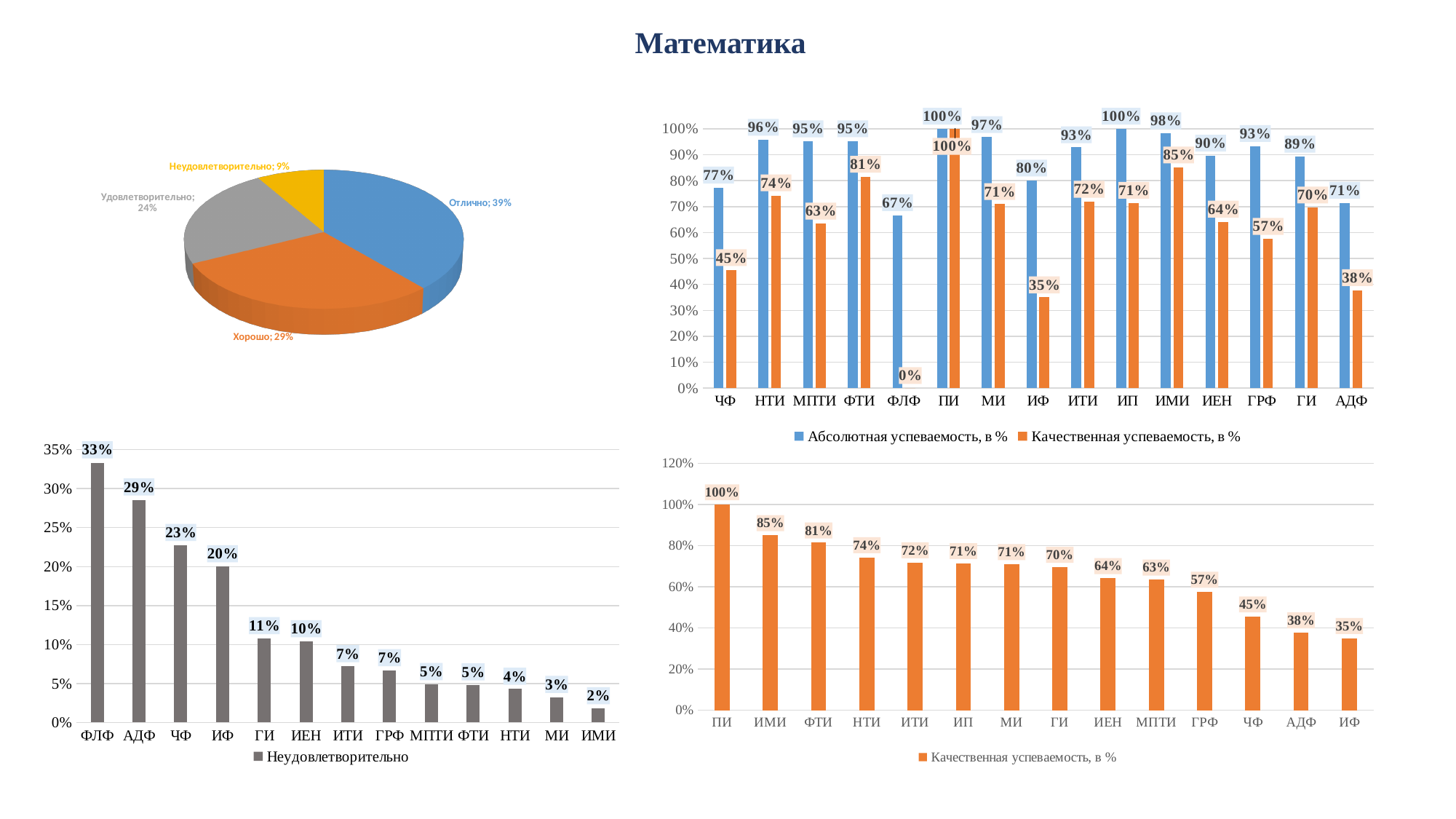
In the grouped bar chart at the top right, which is larger for НТИ: Абсолютная успеваемость or Качественная успеваемость? Абсолютная успеваемость In the pie chart at the top left, what share does the Отлично slice have? 39% In the pie chart at the top left, how many slices are there? 4 In the bar chart at the bottom left (Неудовлетворительно), what is the value for ЧФ? 23% In the bar chart at the bottom left (Неудовлетворительно), which category has the highest value? ФЛФ In the grouped bar chart at the top right, what is the Качественная успеваемость value for ИФ? 35% What kind of chart is shown at the bottom right of the slide? bar chart In the bar chart at the bottom right (Качественная успеваемость), do the values rise or fall from left to right? fall In the grouped bar chart at the top right, how many series does the legend list? 2 In the bar chart at the bottom left (Неудовлетворительно), what is the difference between ФЛФ and АДФ? 4% In the bar chart at the bottom left (Неудовлетворительно), how many categories are shown? 13 In the pie chart at the top left, which category has the smallest slice? Неудовлетворительно